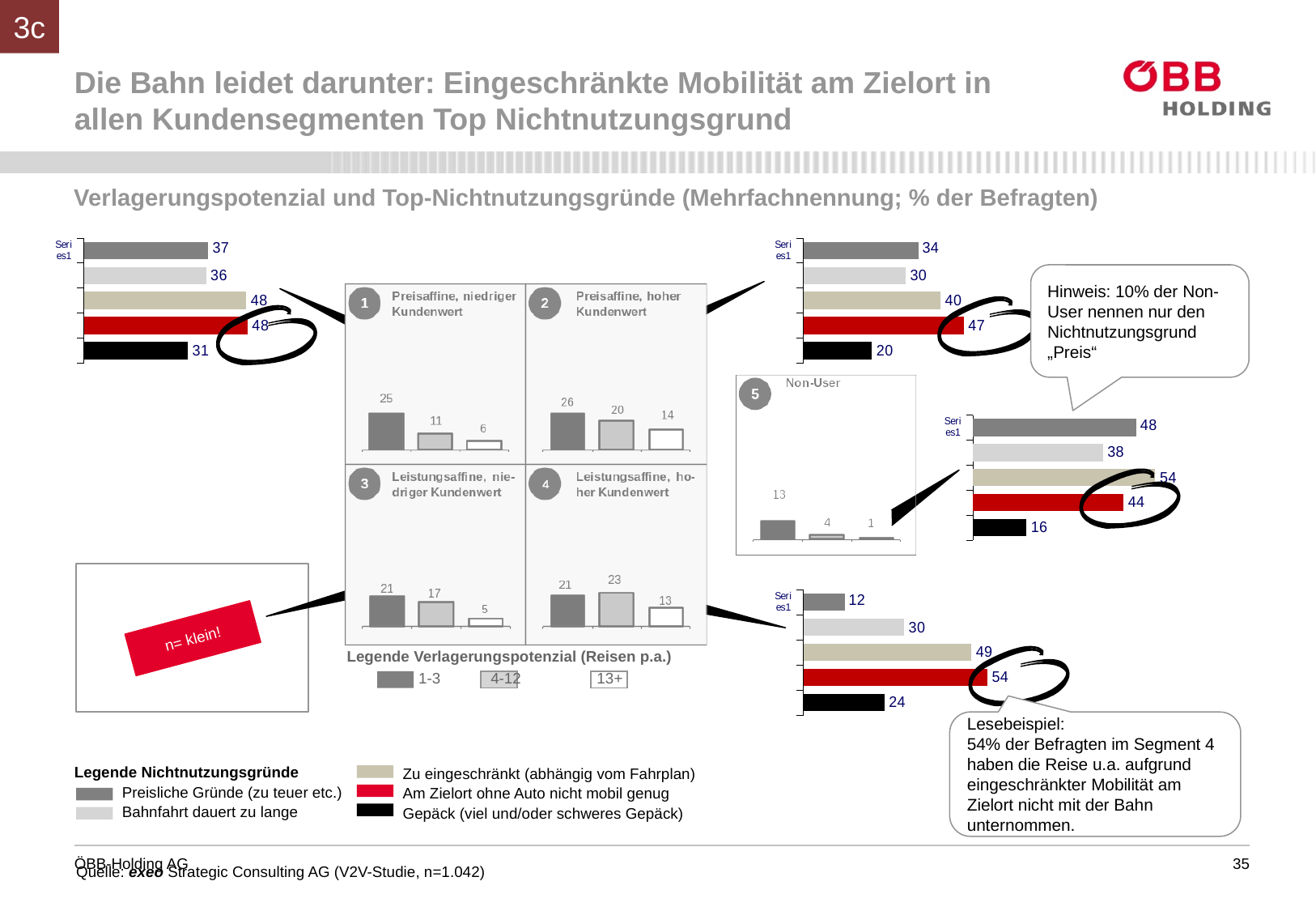
In the top-left horizontal bar chart, what value is shown for the red bar (Am Zielort ohne Auto nicht mobil genug)? 48 In the small chart inside the Non-User box, what value is shown for the third (13+) bar? 1 In the small chart inside the box for segment 1 (Preisaffine, niedriger Kundenwert), what value is shown for the first (dark gray, 1-3) bar? 25 In the bottom-right horizontal bar chart, what is the difference between the red bar (54) and the dark gray bar (12)? 42 In the horizontal bar chart to the right of the Non-User box, what value is shown for the beige bar (Zu eingeschränkt)? 54 In the bottom-right horizontal bar chart (next to segment 4), what is the highest value shown? 54 How many bars does the top-left horizontal bar chart contain? 5 What type of chart is used to show the Nichtnutzungsgründe for each segment? Bar chart How many entries does the 'Legende Nichtnutzungsgründe' list? 5 In the horizontal bar chart to the right of the Non-User box, what value is shown for the black bar (Gepäck)? 16 In the top-right horizontal bar chart, which is larger: the beige bar or the red bar? The red bar (47) In the top-right horizontal bar chart (next to segment 2), which bar has the lowest value and what is it? The black bar (Gepäck), 20